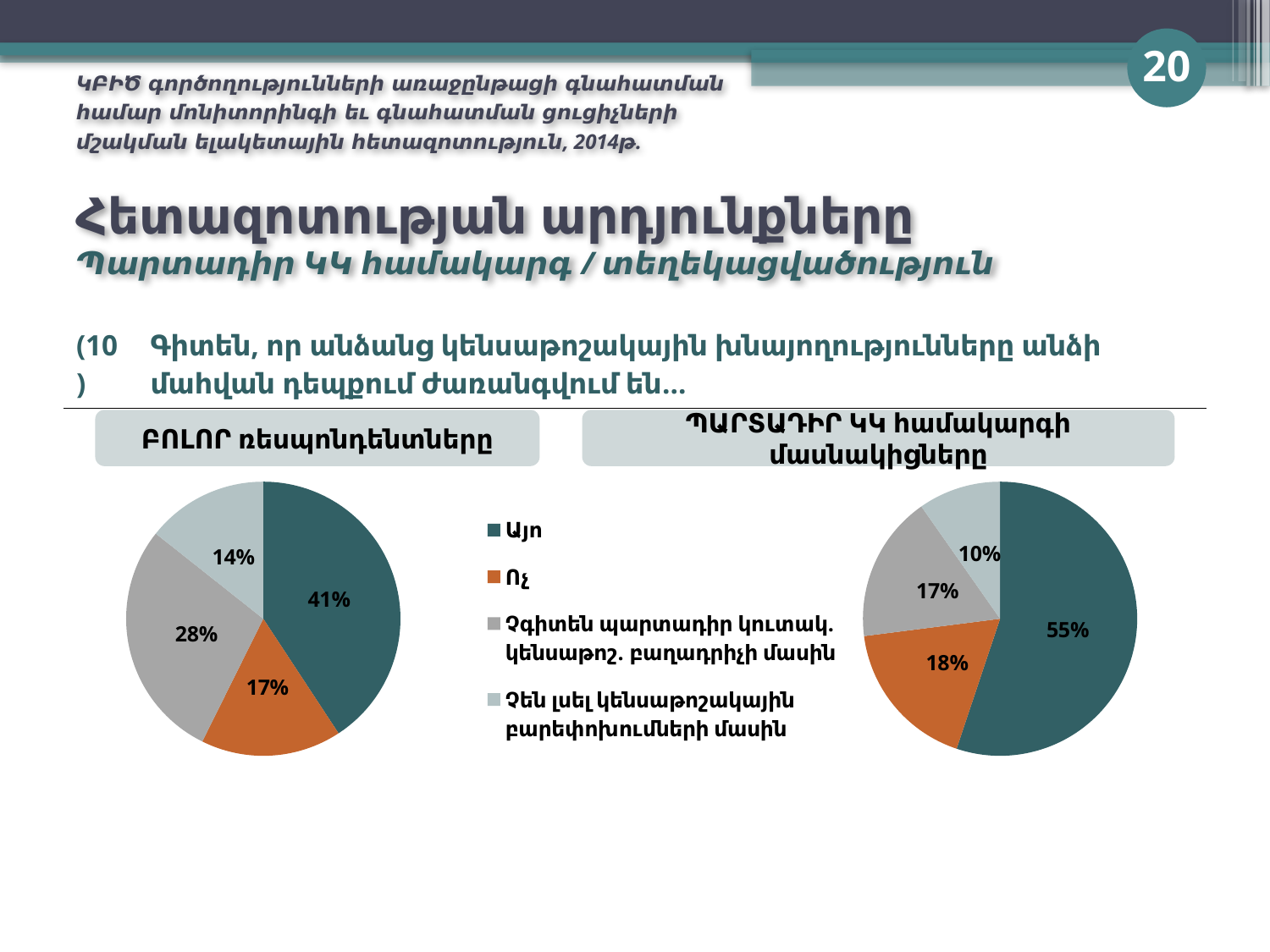
In the right pie chart (ՊԱՐՏԱԴԻՐ ԿԿ համակարգի մասնակիցները), what share is labelled for the "Չեն լսել կենսաթոշակային բարեփոխումների մասին" slice? 10% In the left pie chart (ԲՈԼՈՐ ռեսպոնդենտները), what share is labelled for the "Այո" slice? 41% What colour represents the "Ոչ" category in the pie charts? Orange In the right pie chart (ՊԱՐՏԱԴԻՐ ԿԿ համակարգի մասնակիցները), what share is labelled for the "Այո" slice? 55% How many slices does each pie chart on the slide have? 4 In the left pie chart (ԲՈԼՈՐ ռեսպոնդենտները), which category has the largest slice? Այո In the left pie chart (ԲՈԼՈՐ ռեսպոնդենտները), which is larger: the "Ոչ" slice or the "Չգիտեն պարտադիր կուտակ. կենսաթոշ. բաղադրիչի մասին" slice? Չգիտեն պարտադիր կուտակ. կենսաթոշ. բաղադրիչի մասին In the right pie chart (ՊԱՐՏԱԴԻՐ ԿԿ համակարգի մասնակիցները), which category has the smallest slice? Չեն լսել կենսաթոշակային բարեփոխումների մասին What is the difference between the "Այո" share in the right pie chart (55%) and the "Այո" share in the left pie chart (41%)? 14% In the left pie chart (ԲՈԼՈՐ ռեսպոնդենտները), what share is labelled for the "Ոչ" slice? 17% What type of chart is used on this slide? Pie chart In the left pie chart (ԲՈԼՈՐ ռեսպոնդենտները), which category has the smallest slice? Չեն լսել կենսաթոշակային բարեփոխումների մասին